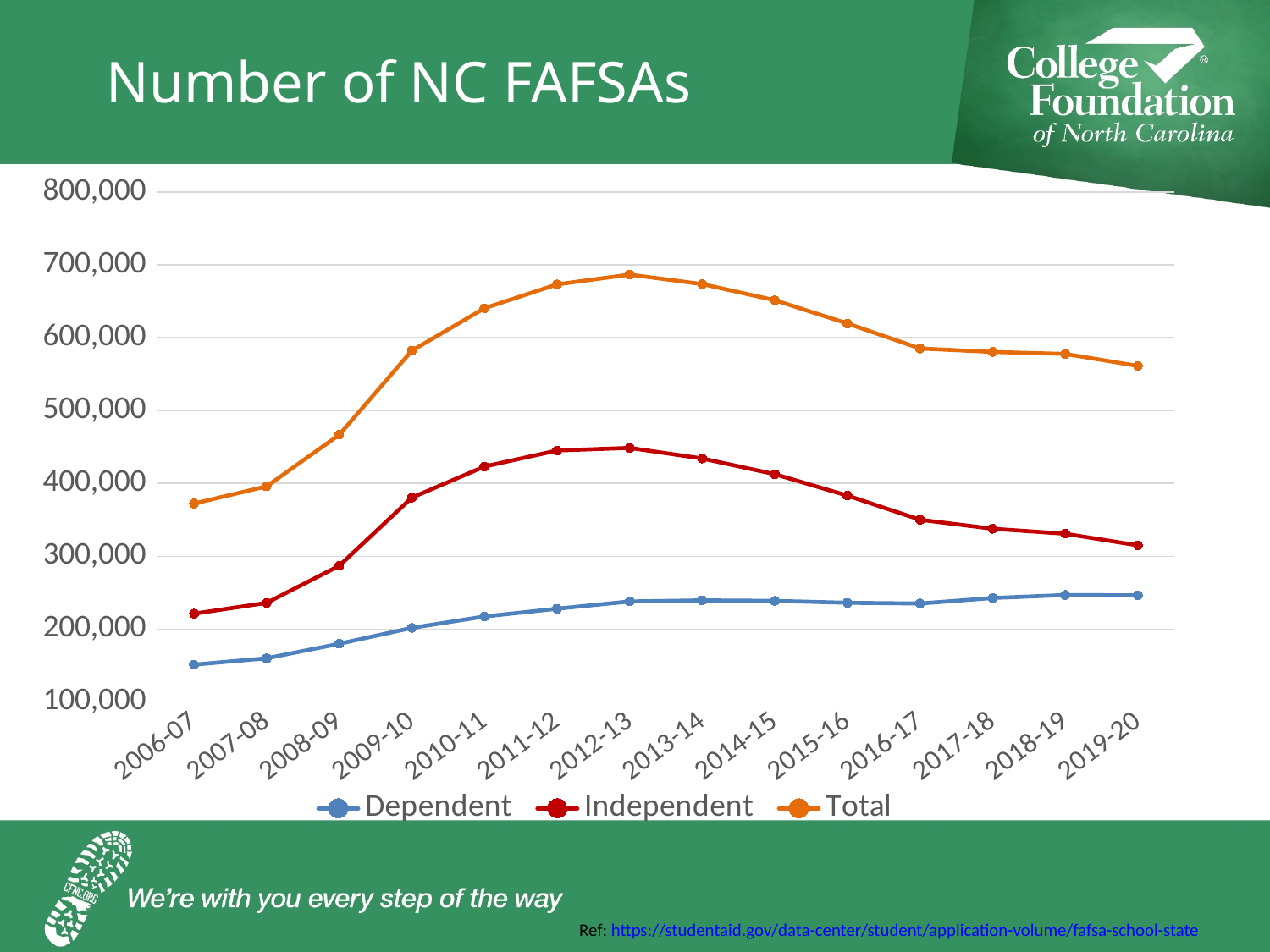
Is the Dependent value for 2006-07 greater or less than 200,000? less How many academic years are plotted along the x axis? 14 Which is larger in 2006-07, the Independent value or the Dependent value? Independent Is the Independent value for 2012-13 greater or less than 400,000? greater Does the Total series rise or fall from 2012-13 to 2019-20? fall In which year does the Total series reach its highest value? 2012-13 Is the Total value for 2012-13 greater or less than 600,000? greater How many series does the legend list? 3 What is the title of the chart? Number of NC FAFSAs In which year is the Total series at its lowest value? 2006-07 What kind of chart is shown on the slide? line chart